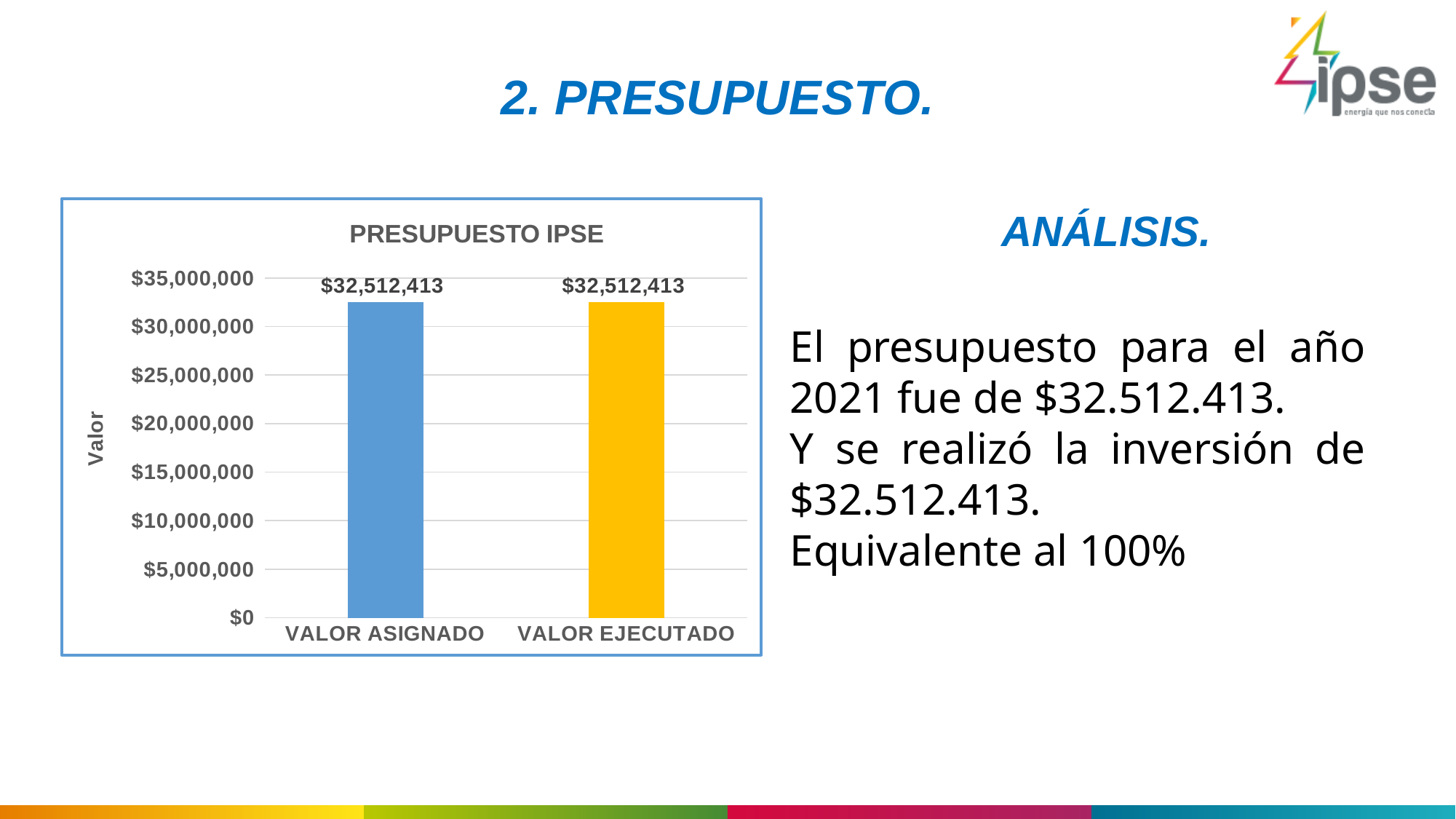
What is the label of the vertical axis? Valor What is the value for VALOR EJECUTADO? $32,512,413 Is the value for VALOR EJECUTADO greater or less than $35,000,000? less What is the total of VALOR ASIGNADO and VALOR EJECUTADO? $65,024,826 What is the title of the chart? PRESUPUESTO IPSE Is the value for VALOR ASIGNADO greater or less than $30,000,000? greater How many categories are shown on the x axis? 2 What kind of chart is shown? bar chart What is the difference between VALOR ASIGNADO and VALOR EJECUTADO? $0 What is the value for VALOR ASIGNADO? $32,512,413